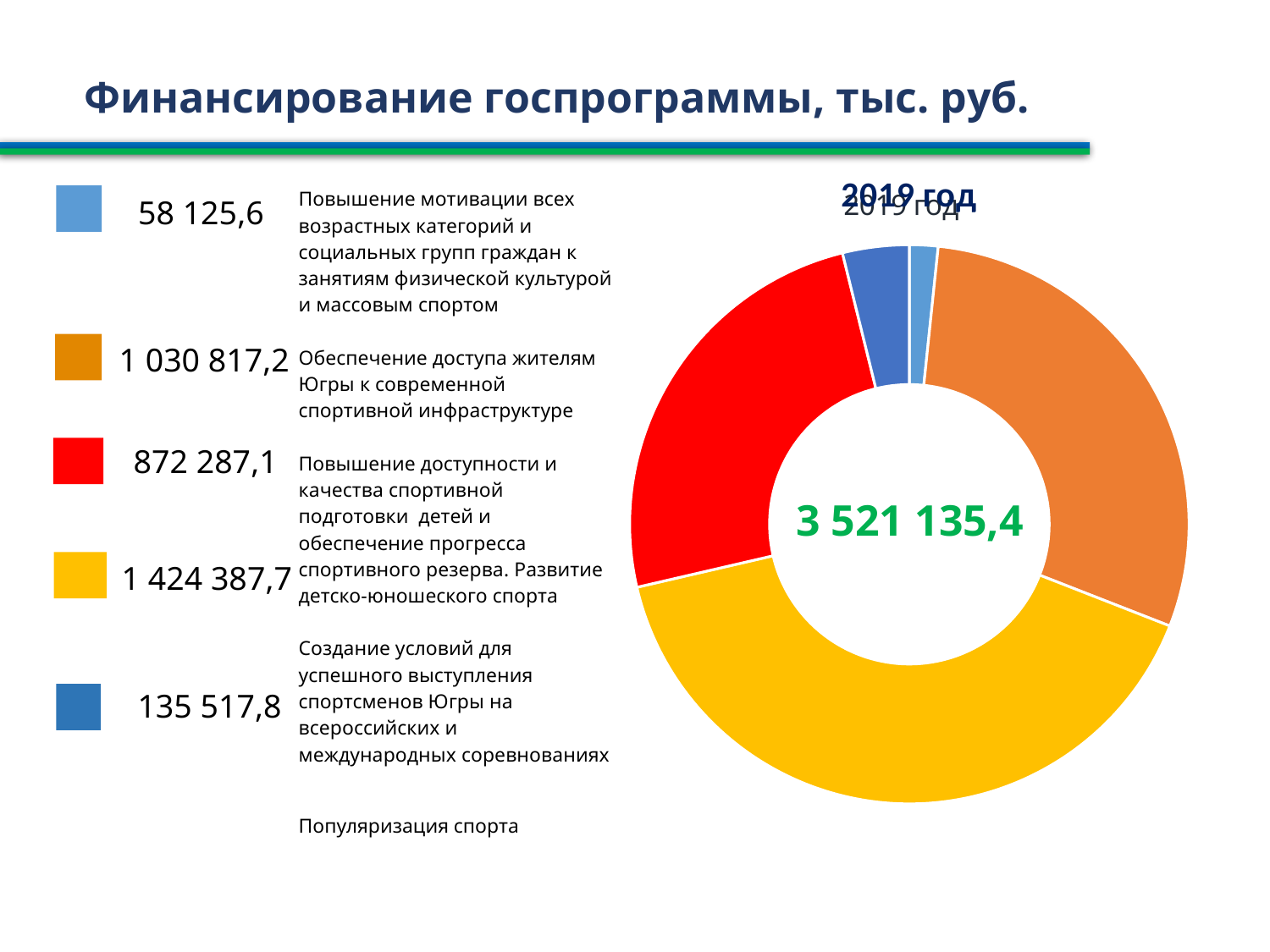
What is the difference between the dark blue slice value (135 517,8) and the light blue slice value (58 125,6)? 77 392,2 What year is given as the title of the donut chart? 2019 год What is the smallest value shown in the chart legend? 58 125,6 What value does the yellow slice of the donut chart represent? 1 424 387,7 What value does the red slice of the donut chart represent? 872 287,1 Which is larger: the orange slice (1 030 817,2) or the red slice (872 287,1)? The orange slice (1 030 817,2) What is the difference between the yellow slice value (1 424 387,7) and the orange slice value (1 030 817,2)? 393 570,5 What is the largest value shown in the chart legend? 1 424 387,7 What kind of chart is shown on the slide? Pie (donut) chart What value does the orange slice of the donut chart represent? 1 030 817,2 How many slices does the donut chart have? 5 What total value is printed in the centre of the donut chart? 3 521 135,4